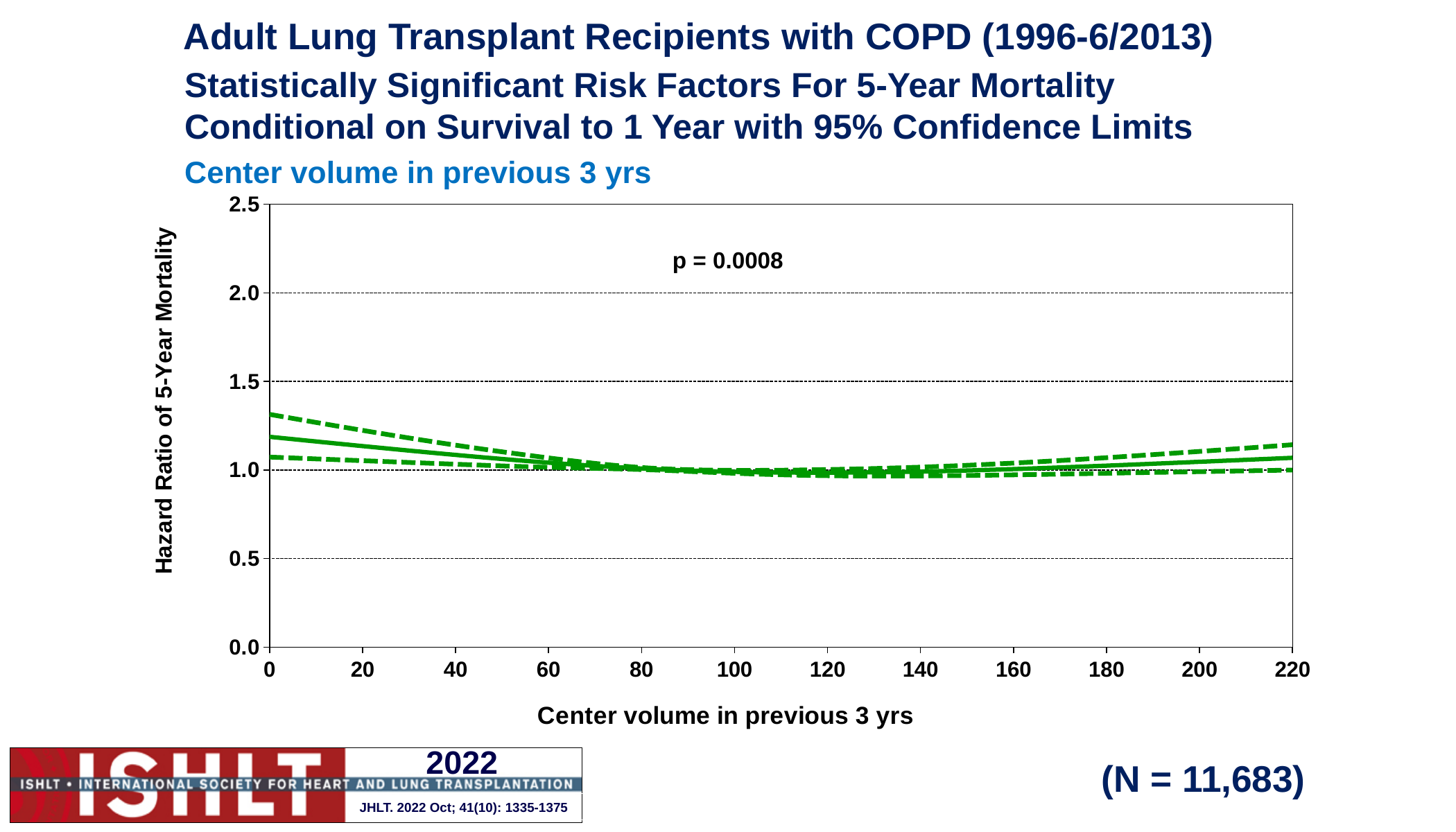
Is the hazard ratio (solid line) at a center volume of 0 greater or less than 1.5? less What kind of chart is shown on the slide? line chart What is the largest center volume value shown on the x axis? 220 How many lines are plotted on the chart? 3 Does the hazard ratio (solid line) rise or fall as center volume increases from 0 to 100? fall Is the upper confidence limit (upper dashed line) at a center volume of 0 greater or less than 1.5? less Is the hazard ratio (solid line) at a center volume of 0 greater or less than 1.0? greater Does the hazard ratio (solid line) rise or fall as center volume increases from 140 to 220? rise What is the highest value shown on the y axis? 2.5 Is the hazard ratio (solid line) at a center volume of 0 greater or less than the hazard ratio at a center volume of 100? greater What is the label of the x axis? Center volume in previous 3 yrs What is the p-value printed on the chart? p = 0.0008